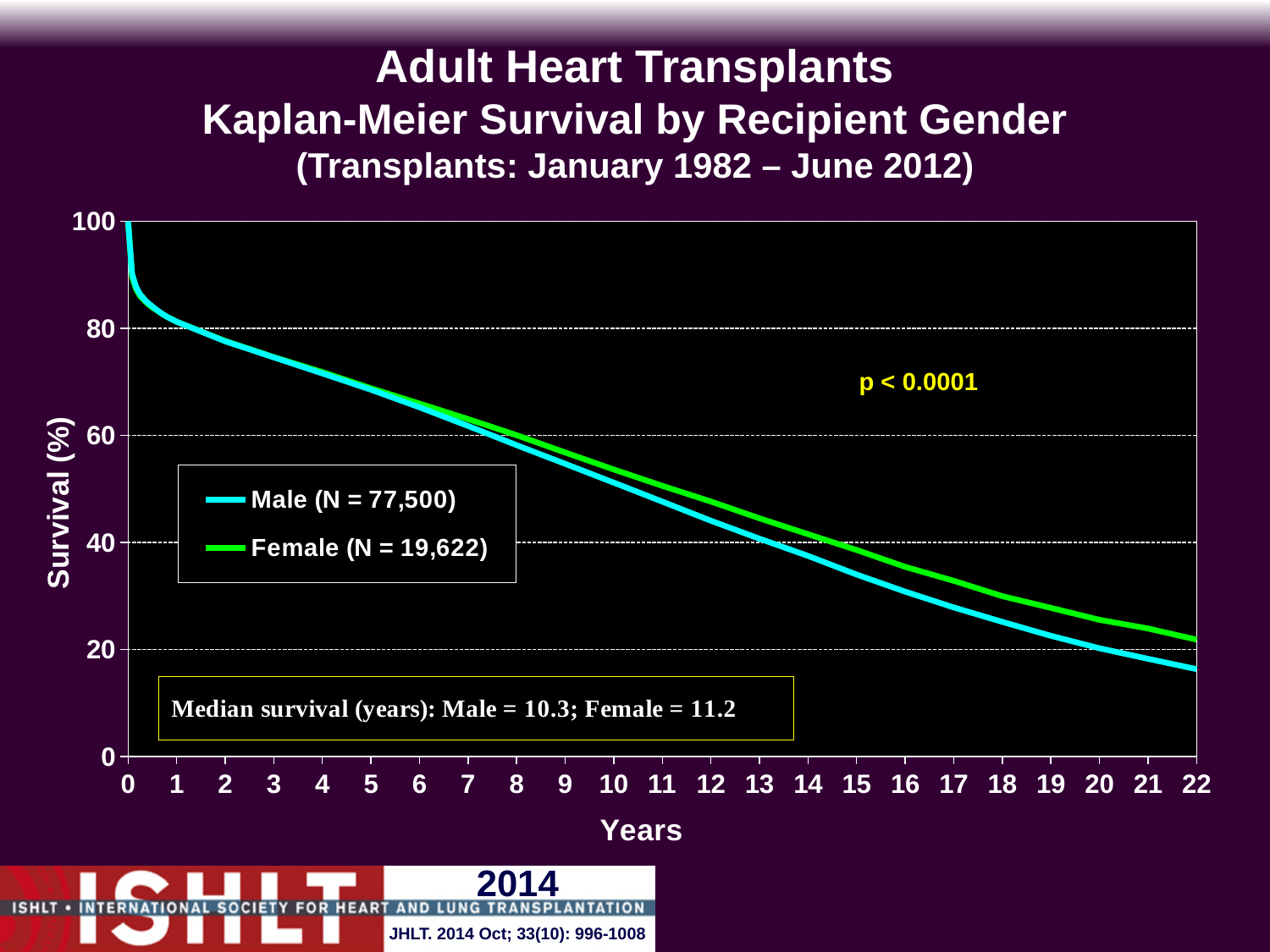
Do the survival curves rise or fall as years since transplant increase? Fall How many series does the legend list? 2 What is the difference in median survival (years) between female and male recipients? 0.9 What is the number of female recipients (N) shown in the legend? 19,622 Is the survival value for female recipients at 5 years greater or less than 60? greater What p-value is shown on the chart? p < 0.0001 What kind of chart is shown on the slide? Line chart What is the median survival in years for male recipients? 10.3 Which group has the higher median survival, male or female recipients? Female What is the median survival in years for female recipients? 11.2 Is the survival value for male recipients at 22 years greater or less than 20? less What is the number of male recipients (N) shown in the legend? 77,500